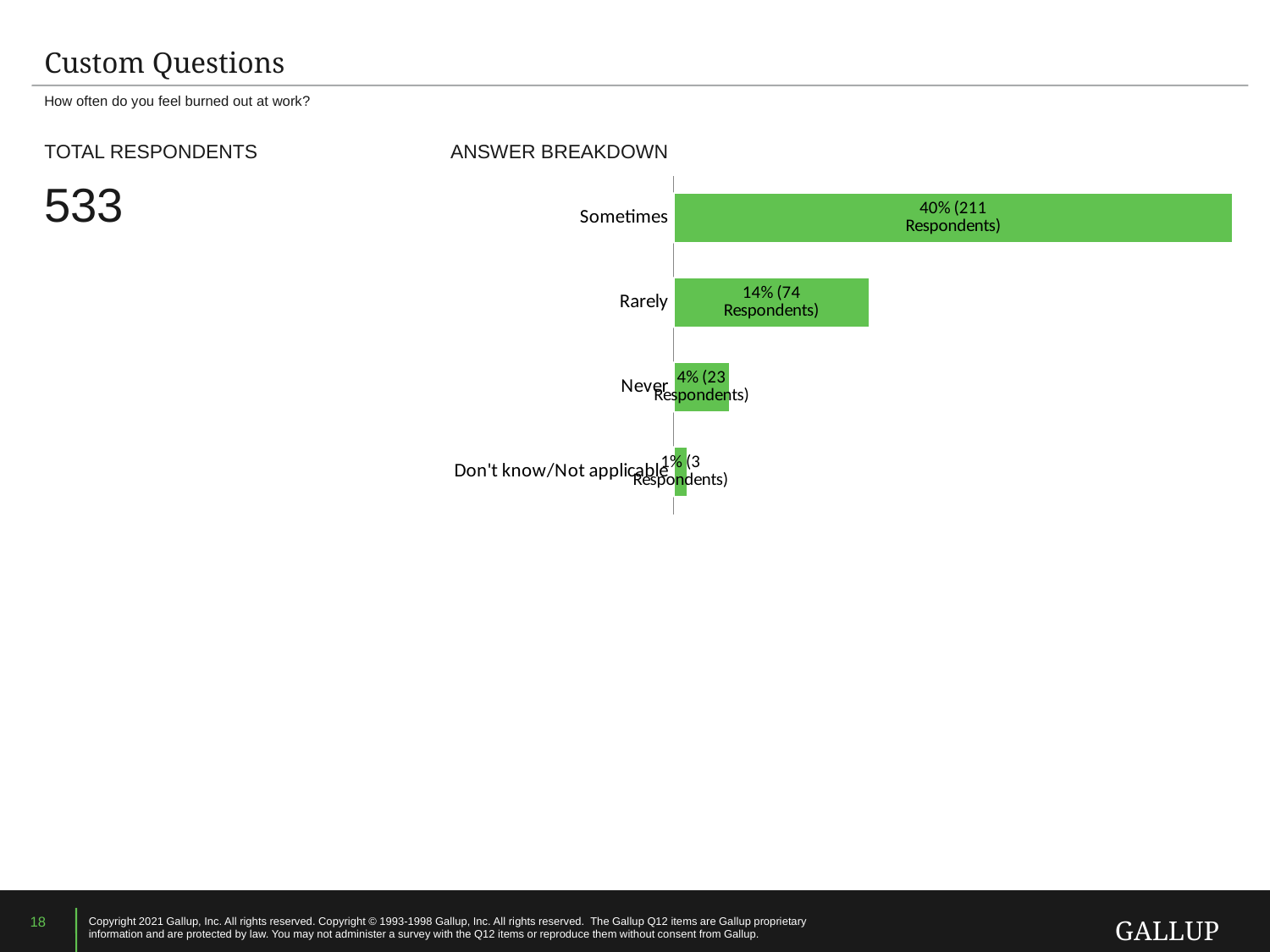
How many answer categories are shown in the chart? 4 What is the difference in percentage points between "Sometimes" and "Rarely"? 26 How many respondents answered "Rarely"? 74 How many respondents answered "Don't know/Not applicable"? 3 How many more respondents answered "Rarely" than "Never"? 51 What is the total number of respondents shown on the slide? 533 Which answer category has the highest percentage of respondents? Sometimes Which has more respondents, "Never" or "Don't know/Not applicable"? Never What percentage of respondents answered "Never"? 4% What percentage of respondents answered "Sometimes" to the question about feeling burned out at work? 40% What type of chart is used to show the answer breakdown? Bar chart Which answer category has the lowest percentage of respondents? Don't know/Not applicable